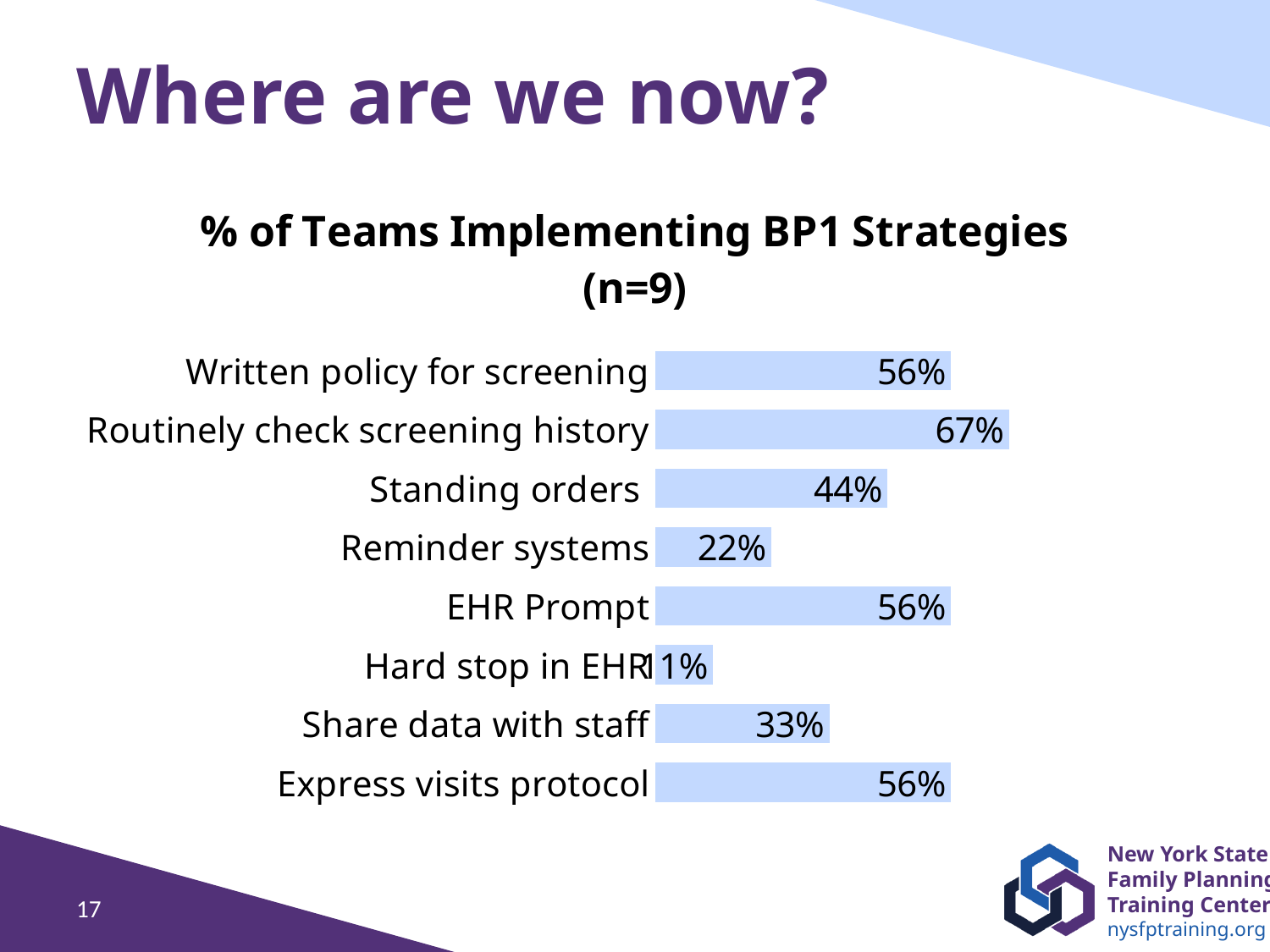
What is the value for Express visits protocol? 56% What is the value for Routinely check screening history? 67% Which strategy has the highest percentage of teams implementing it? Routinely check screening history What is the value for Share data with staff? 33% What is the value for Reminder systems? 22% What is the value for Standing orders? 44% Which strategy has the lowest percentage of teams implementing it? Hard stop in EHR Which is larger, the value for Share data with staff or the value for Reminder systems? Share data with staff What is the difference between the values for Routinely check screening history and Standing orders? 23% How many strategies are shown in the chart? 8 What kind of chart is shown on the slide? Bar chart What is the title of the chart? % of Teams Implementing BP1 Strategies (n=9)